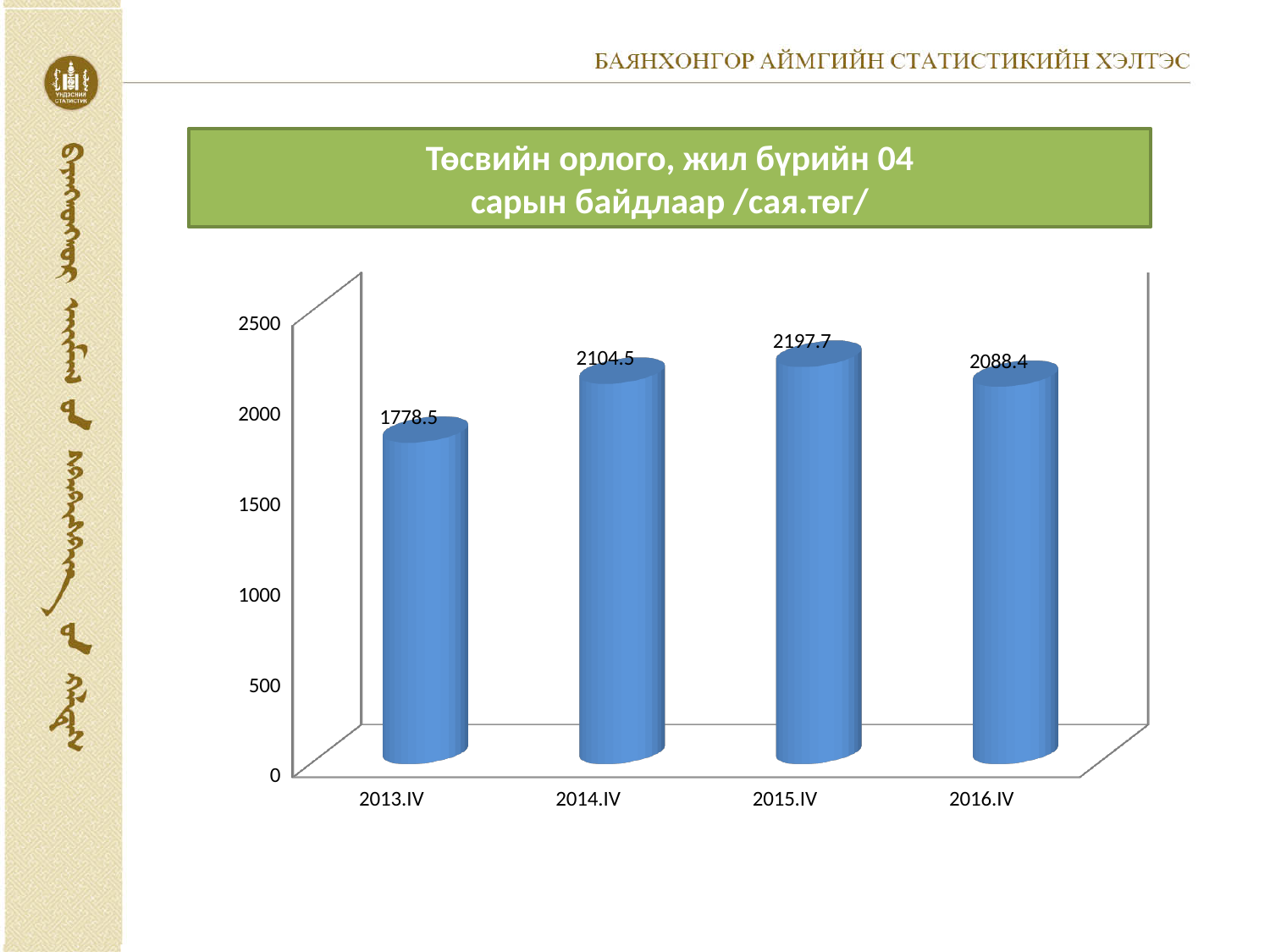
Which category has the highest value? 2015.IV Which category has the lowest value? 2013.IV What is the value for 2013.IV? 1778.5 How many categories are shown on the x axis? 4 Is the value for 2013.IV greater or less than 2000? less What is the value for 2015.IV? 2197.7 What kind of chart is shown on the slide? bar chart Which is larger, the value for 2014.IV or the value for 2013.IV? 2014.IV What is the difference between the values for 2015.IV and 2013.IV? 419.2 Does the value rise or fall from 2015.IV to 2016.IV? fall What is the difference between the values for 2014.IV and 2016.IV? 16.1 What is the value for 2016.IV? 2088.4